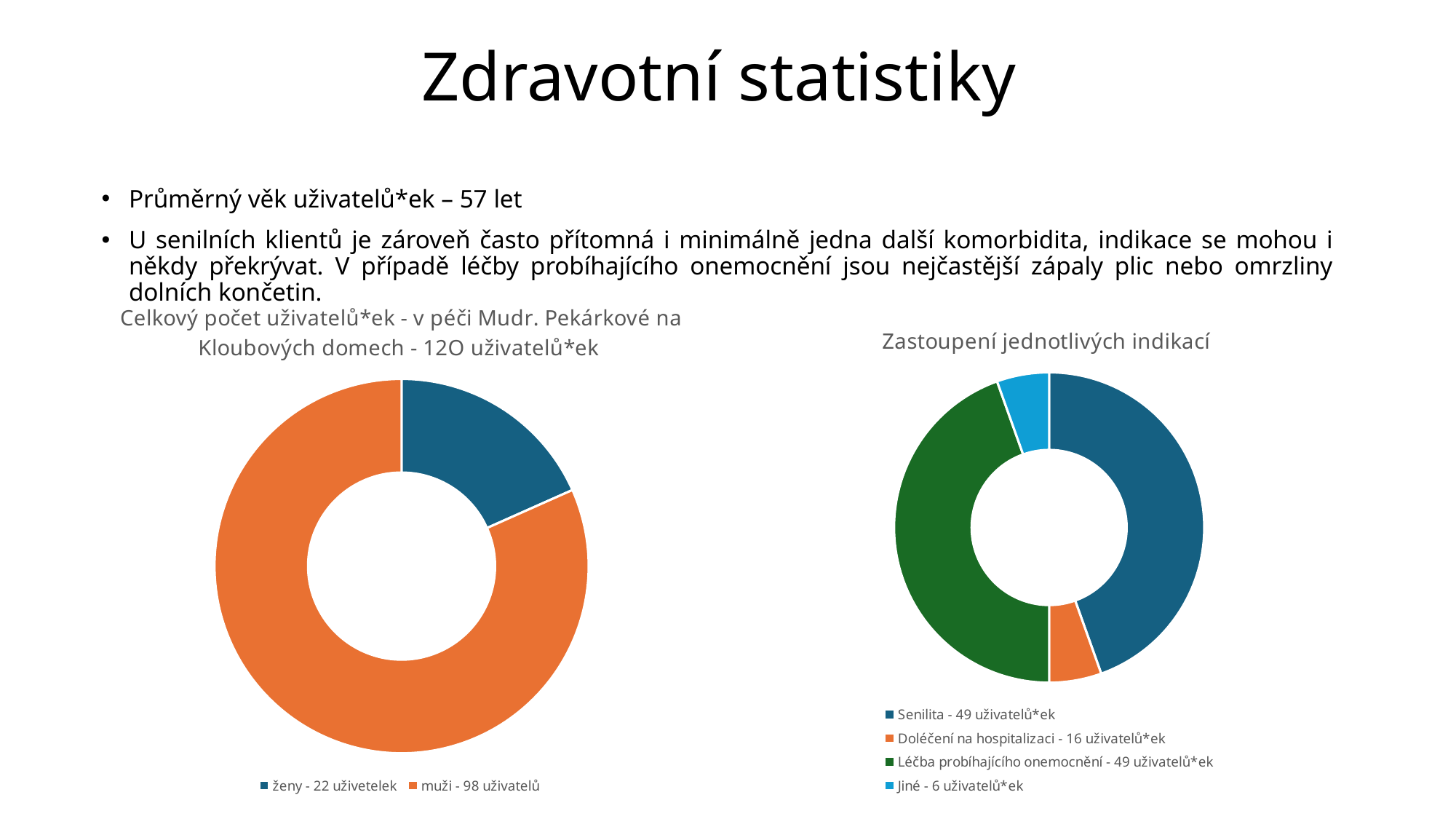
On the left chart (Celkový počet uživatelů*ek), how many slices does the doughnut have? 2 On the left chart (Celkový počet uživatelů*ek), how many users are listed for 'muži' in the legend? 98 uživatelů On the right chart (Zastoupení jednotlivých indikací), how many entries does the legend list? 4 On the left chart (Celkový počet uživatelů*ek), what is the difference between the number of muži and ženy? 76 On the right chart (Zastoupení jednotlivých indikací), how many users are listed for 'Doléčení na hospitalizaci'? 16 uživatelů*ek On the right chart (Zastoupení jednotlivých indikací), what is the difference between Senilita and Doléčení na hospitalizaci? 33 On the left chart (Celkový počet uživatelů*ek), how many users are listed for 'ženy' in the legend? 22 uživetelek On the right chart (Zastoupení jednotlivých indikací), how many users are listed for 'Jiné'? 6 uživatelů*ek On the right chart (Zastoupení jednotlivých indikací), which is larger: Doléčení na hospitalizaci or Jiné? Doléčení na hospitalizaci What type of chart is used on the right side of the slide (Zastoupení jednotlivých indikací)? Doughnut (pie) chart On the left chart (Celkový počet uživatelů*ek), which category has the larger slice? muži